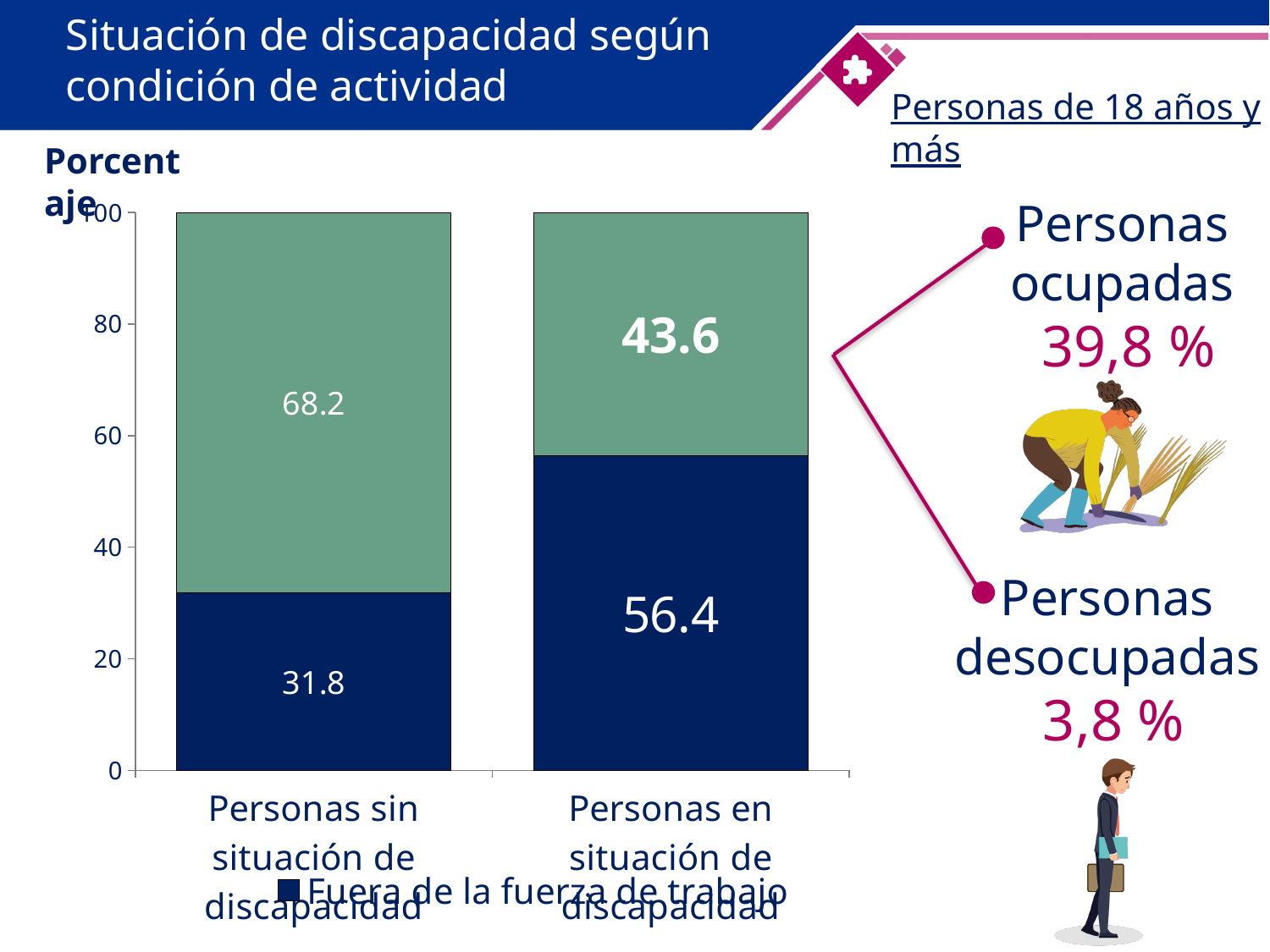
How many categories are shown on the x axis of the chart? 2 What is the difference between the "Fuera de la fuerza de trabajo" values for "Personas en situación de discapacidad" and "Personas sin situación de discapacidad"? 24.6 Which category has the larger "Fuera de la fuerza de trabajo" value? Personas en situación de discapacidad What is the total of the stacked bar for "Personas sin situación de discapacidad"? 100 Which category has the smaller green segment value? Personas en situación de discapacidad Is the "Fuera de la fuerza de trabajo" value for "Personas sin situación de discapacidad" greater or less than 40? less What kind of chart is shown on the slide? Stacked bar chart What value is shown in the green segment of the bar for "Personas sin situación de discapacidad"? 68.2 What is the value of "Fuera de la fuerza de trabajo" for "Personas en situación de discapacidad"? 56.4 What is the value of "Fuera de la fuerza de trabajo" for "Personas sin situación de discapacidad"? 31.8 What is the label of the vertical axis of the chart? Porcentaje What value is shown in the green segment of the bar for "Personas en situación de discapacidad"? 43.6